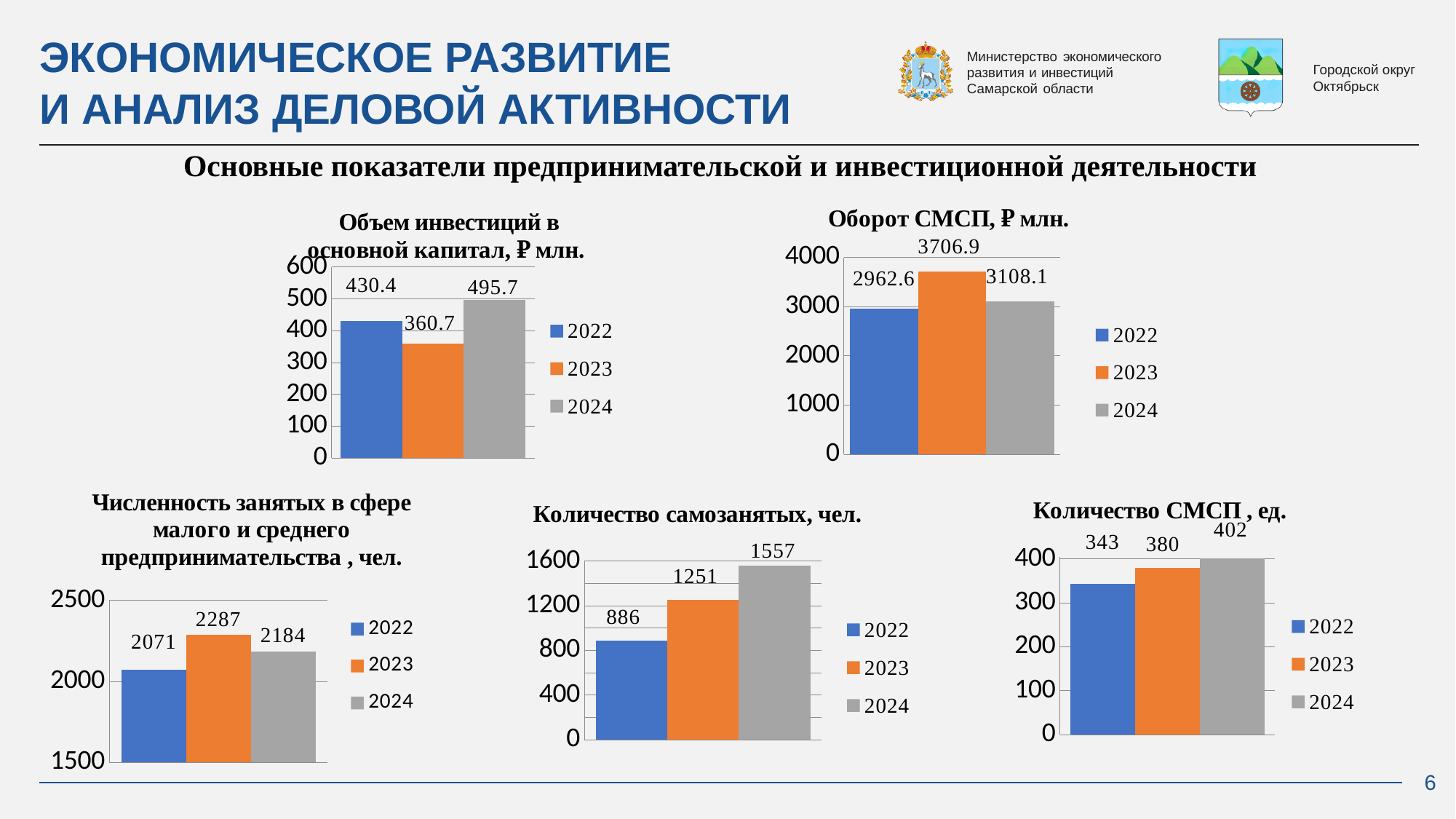
In the chart 'Численность занятых в сфере малого и среднего предпринимательства, чел.', what is the value for 2024? 2184 In the chart 'Объем инвестиций в основной капитал, ₽ млн.', which year has the highest value? 2024 In the chart 'Количество СМСП, ед.', what is the difference between the 2024 and 2022 values? 59 How many series does the legend list in the chart 'Количество СМСП, ед.'? 3 In the chart 'Оборот СМСП, ₽ млн.', what is the value for 2023? 3706.9 In the chart 'Количество самозанятых, чел.', do the values rise or fall from 2022 to 2024? rise In the chart 'Оборот СМСП, ₽ млн.', which year has the lowest value? 2022 What kind of chart is 'Количество самозанятых, чел.'? bar chart In the chart 'Количество самозанятых, чел.', what is the value for 2022? 886 In the chart 'Численность занятых в сфере малого и среднего предпринимательства, чел.', which is larger, the value for 2023 or 2024? 2023 In the chart 'Оборот СМСП, ₽ млн.', what is the difference between the 2023 and 2022 values? 744.3 In the chart 'Объем инвестиций в основной капитал, ₽ млн.', what is the value for 2023? 360.7